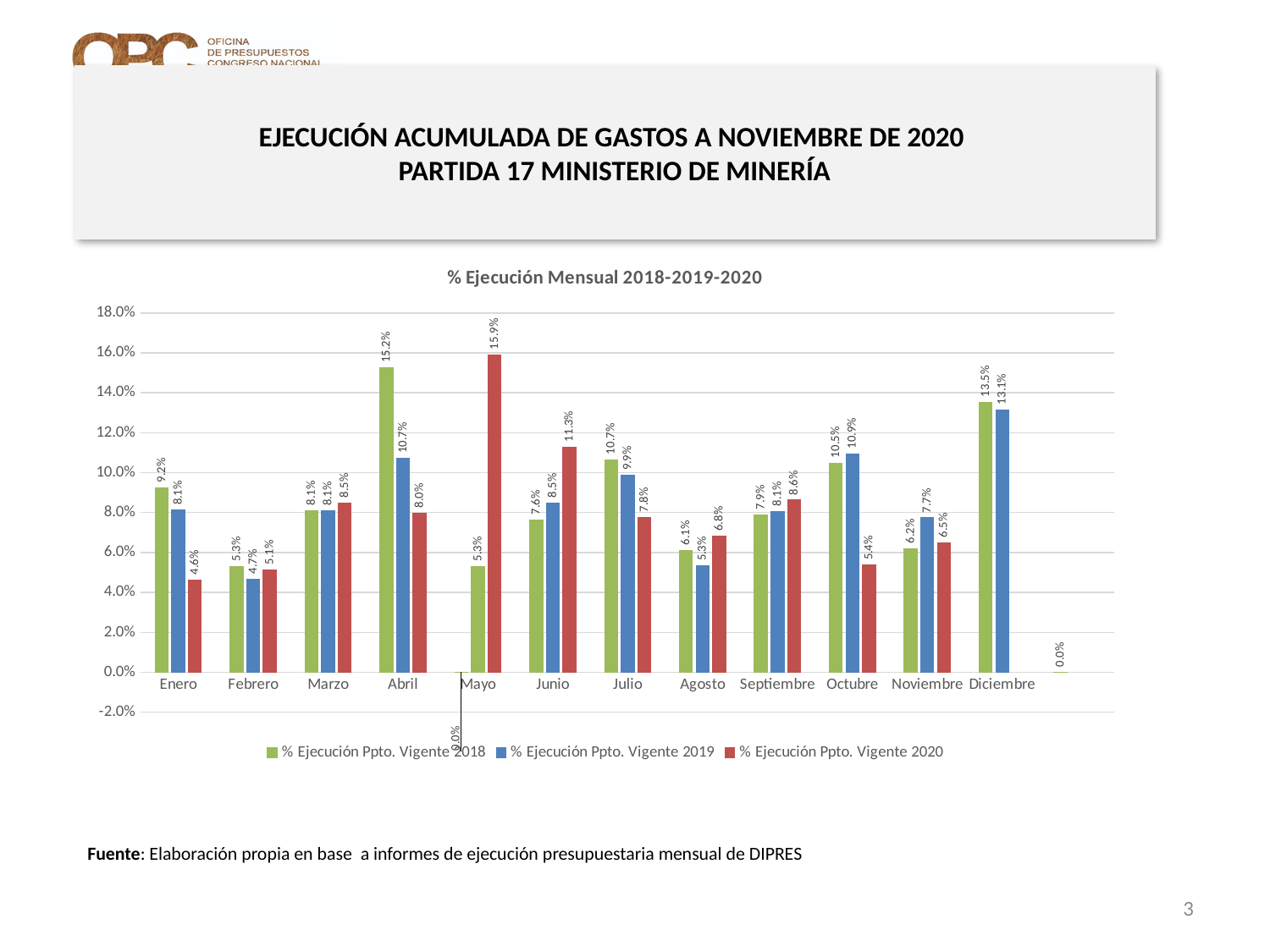
In Junio, which is larger: the 2018 value or the 2020 value? 2020 How many series does the legend list? 3 What is the value for % Ejecución Ppto. Vigente 2018 in Enero? 9.2% What is the difference between the 2018 and 2020 values in Abril? 7.2 percentage points What is the value for % Ejecución Ppto. Vigente 2019 in Abril? 10.7% In which month is the % Ejecución Ppto. Vigente 2020 value highest? Mayo How many months are shown on the x axis? 12 What type of chart is shown on the slide? Bar chart In which month is the % Ejecución Ppto. Vigente 2019 value lowest? Febrero What is the value for % Ejecución Ppto. Vigente 2020 in Octubre? 5.4% In which month is the % Ejecución Ppto. Vigente 2018 value highest? Abril What is the value for % Ejecución Ppto. Vigente 2018 in Diciembre? 13.5%